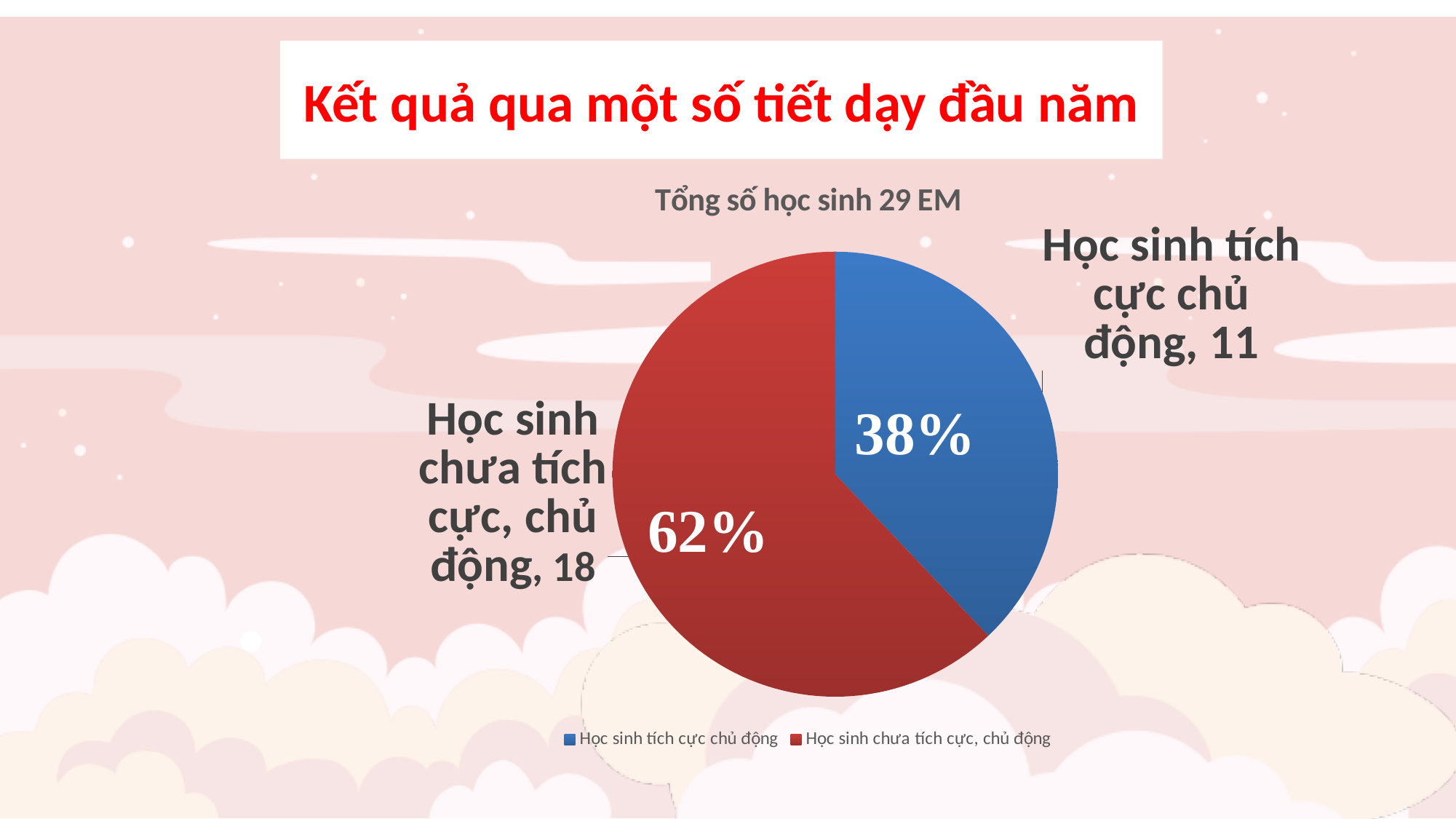
How many entries does the legend list? 2 Which category has the smallest slice? Học sinh tích cực chủ động What is the difference between the values for Học sinh chưa tích cực, chủ động and Học sinh tích cực chủ động? 7 What is the value for Học sinh tích cực chủ động? 11 Which colour represents Học sinh tích cực chủ động in the pie chart? blue How many slices does the pie chart have? 2 What percentage share of the pie is Học sinh chưa tích cực, chủ động? 62% What is the value for Học sinh chưa tích cực, chủ động? 18 What percentage share of the pie is Học sinh tích cực chủ động? 38% What is the chart's title? Tổng số học sinh 29 EM What kind of chart is shown on the slide? pie chart Which category has the largest slice? Học sinh chưa tích cực, chủ động